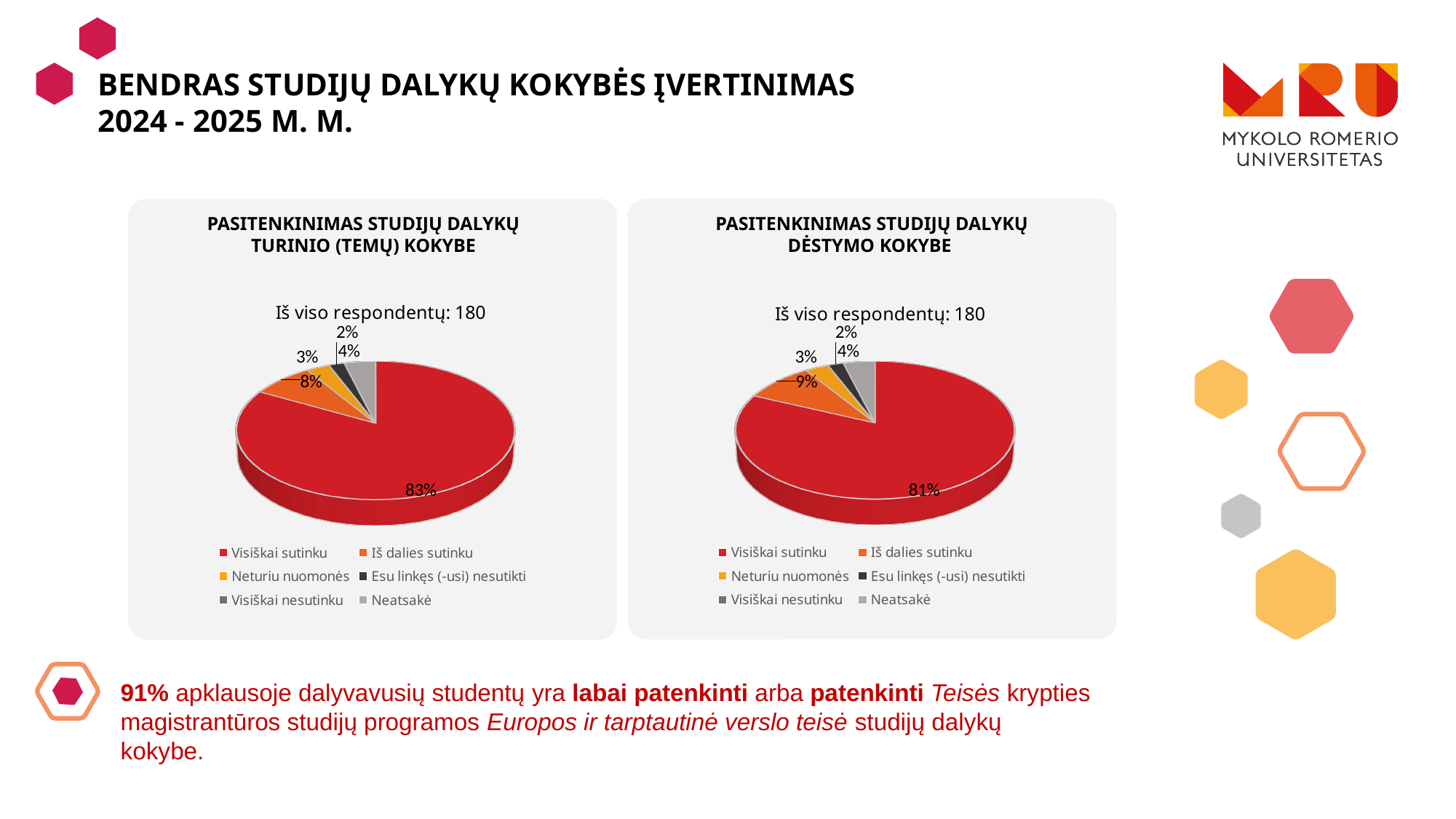
In the left chart (Pasitenkinimas studijų dalykų turinio (temų) kokybe), what colour is the 'Visiškai sutinku' slice? Red In the right chart (Pasitenkinimas studijų dalykų dėstymo kokybe), what share of respondents answered 'Iš dalies sutinku'? 9% In the right chart (Pasitenkinimas studijų dalykų dėstymo kokybe), what share of respondents answered 'Visiškai sutinku'? 81% How many respondents in total are reported for the left chart (Pasitenkinimas studijų dalykų turinio (temų) kokybe)? 180 What kind of charts are shown on the slide? Pie charts In the left chart (Pasitenkinimas studijų dalykų turinio (temų) kokybe), what share of respondents answered 'Iš dalies sutinku'? 8% Which chart has the larger share for 'Visiškai sutinku', the left one (turinio kokybe) or the right one (dėstymo kokybe)? The left one (turinio kokybe) How many answer categories does the legend of the right chart (Pasitenkinimas studijų dalykų dėstymo kokybe) list? 6 In the right chart (Pasitenkinimas studijų dalykų dėstymo kokybe), which answer category has the largest share? Visiškai sutinku In the left chart (Pasitenkinimas studijų dalykų turinio (temų) kokybe), which answer category has the largest share? Visiškai sutinku In the left chart (Pasitenkinimas studijų dalykų turinio (temų) kokybe), what share of respondents answered 'Visiškai sutinku'? 83% What is the difference between the 'Visiškai sutinku' share in the left chart and in the right chart? 2%